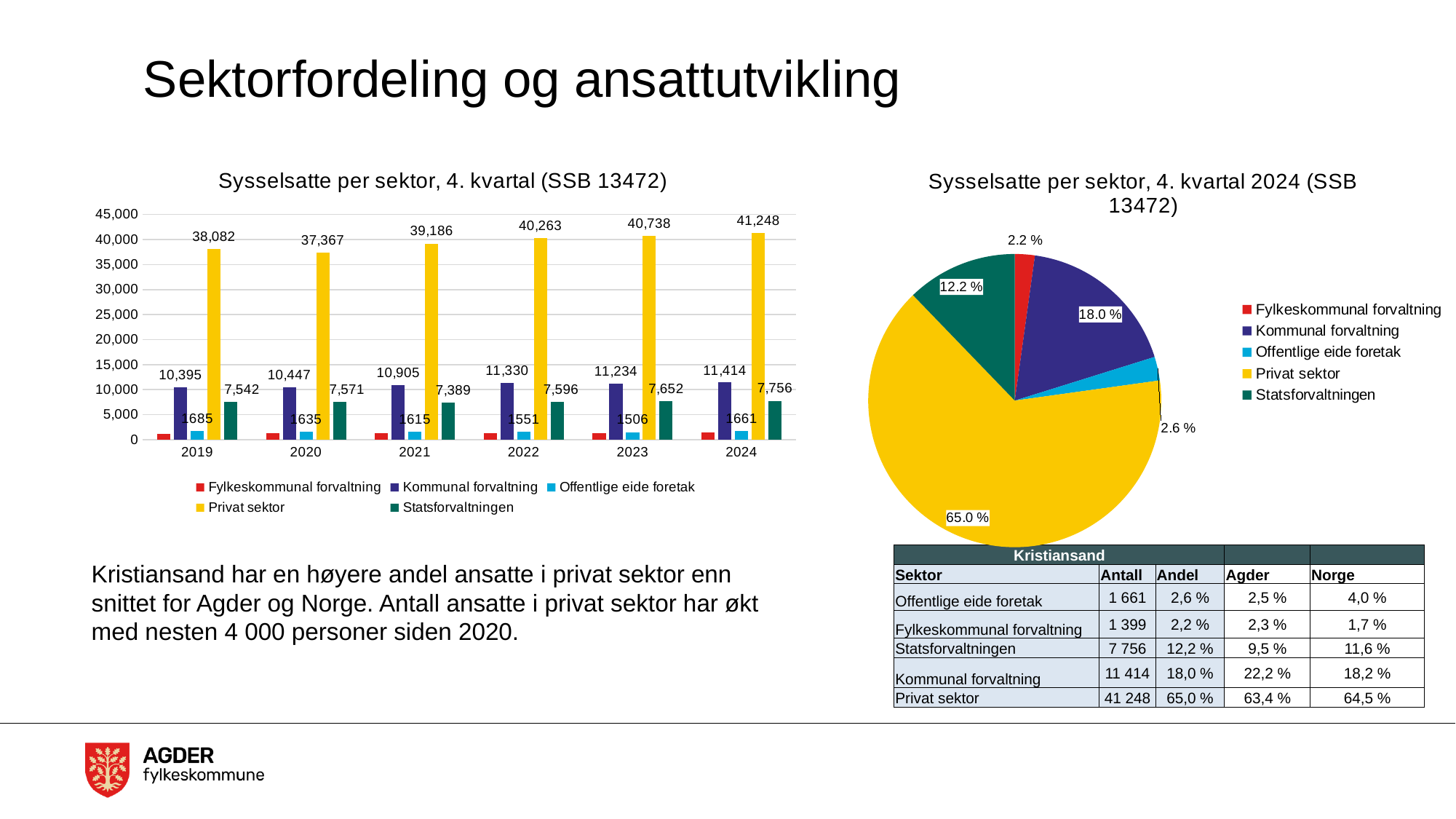
In the bar chart 'Sysselsatte per sektor, 4. kvartal (SSB 13472)', what is the value for Kommunal forvaltning in 2021? 10,905 In the bar chart 'Sysselsatte per sektor, 4. kvartal (SSB 13472)', what is the value for Privat sektor in 2024? 41,248 In the pie chart 'Sysselsatte per sektor, 4. kvartal 2024 (SSB 13472)', what share does Privat sektor have? 65.0 % In the bar chart 'Sysselsatte per sektor, 4. kvartal (SSB 13472)', by how much did Privat sektor increase from 2020 to 2024? 3,881 In the bar chart 'Sysselsatte per sektor, 4. kvartal (SSB 13472)', what is the value for Statsforvaltningen in 2019? 7,542 In the bar chart 'Sysselsatte per sektor, 4. kvartal (SSB 13472)', how many series does the legend list? 5 In the bar chart 'Sysselsatte per sektor, 4. kvartal (SSB 13472)', is the value for Kommunal forvaltning higher in 2022 or in 2023? 2022 In the bar chart 'Sysselsatte per sektor, 4. kvartal (SSB 13472)', is the value for Fylkeskommunal forvaltning in 2024 greater or less than 5,000? less In the bar chart 'Sysselsatte per sektor, 4. kvartal (SSB 13472)', which year has the lowest value for Privat sektor? 2020 In the bar chart 'Sysselsatte per sektor, 4. kvartal (SSB 13472)', what is the value for Offentlige eide foretak in 2023? 1506 In the pie chart 'Sysselsatte per sektor, 4. kvartal 2024 (SSB 13472)', what share does Statsforvaltningen have? 12.2 % In the bar chart 'Sysselsatte per sektor, 4. kvartal (SSB 13472)', how many years are shown on the x axis? 6